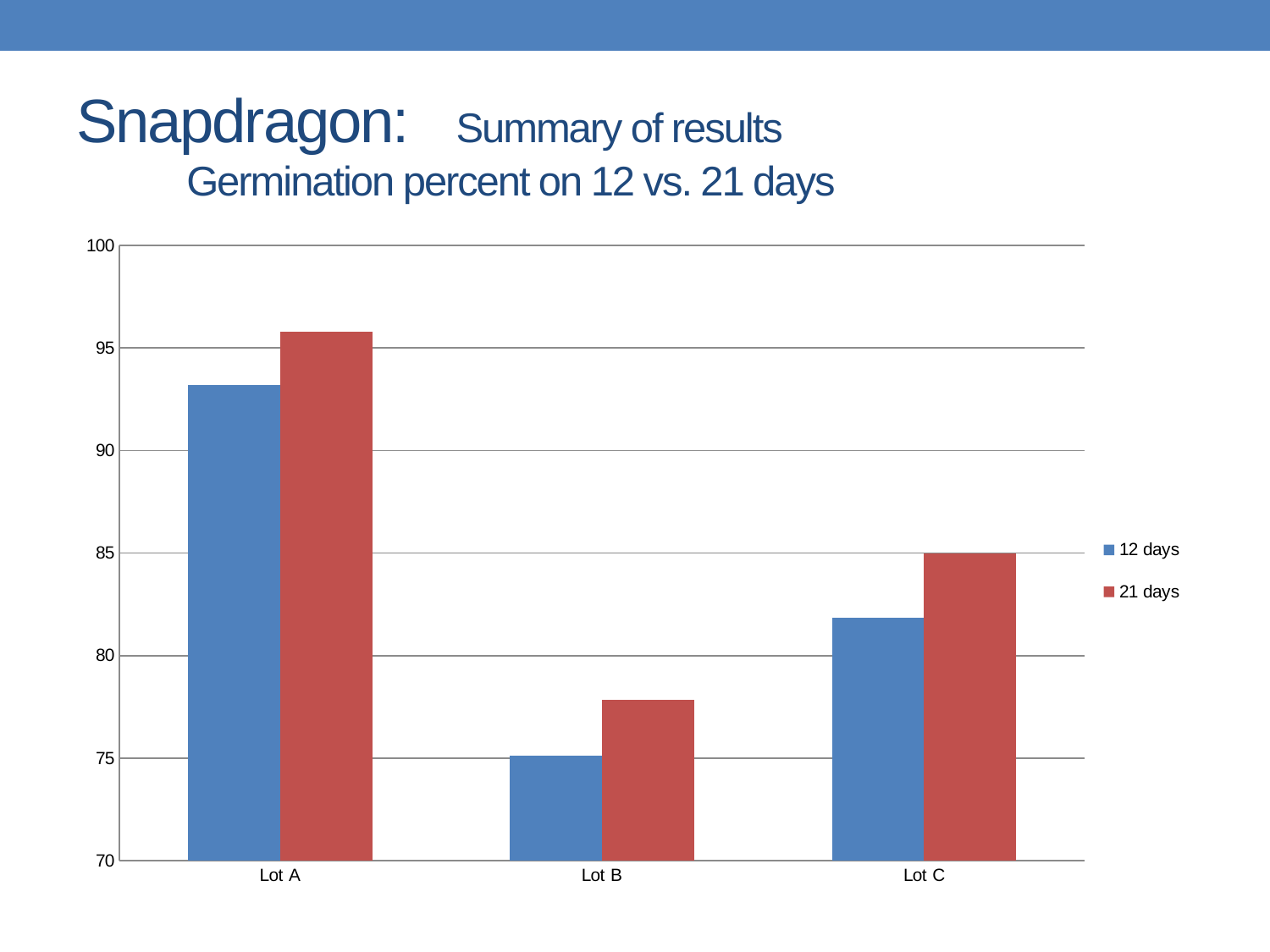
Which lot has the highest germination percent at 21 days? Lot A Is the 21 days value for Lot B greater or less than 80? less For Lot C, which is larger: the 12 days value or the 21 days value? 21 days What kind of chart is shown on the slide? bar chart How many series does the legend list? 2 What colour are the bars for the 21 days series? red Which lot has the lowest germination percent at 21 days? Lot B Is the 12 days value for Lot C greater or less than 80? greater Which is larger: the 12 days value for Lot A or the 21 days value for Lot C? 12 days value for Lot A How many lots (categories) are shown on the x axis? 3 Is the 12 days value for Lot A greater or less than 90? greater Which lot has the lowest germination percent at 12 days? Lot B